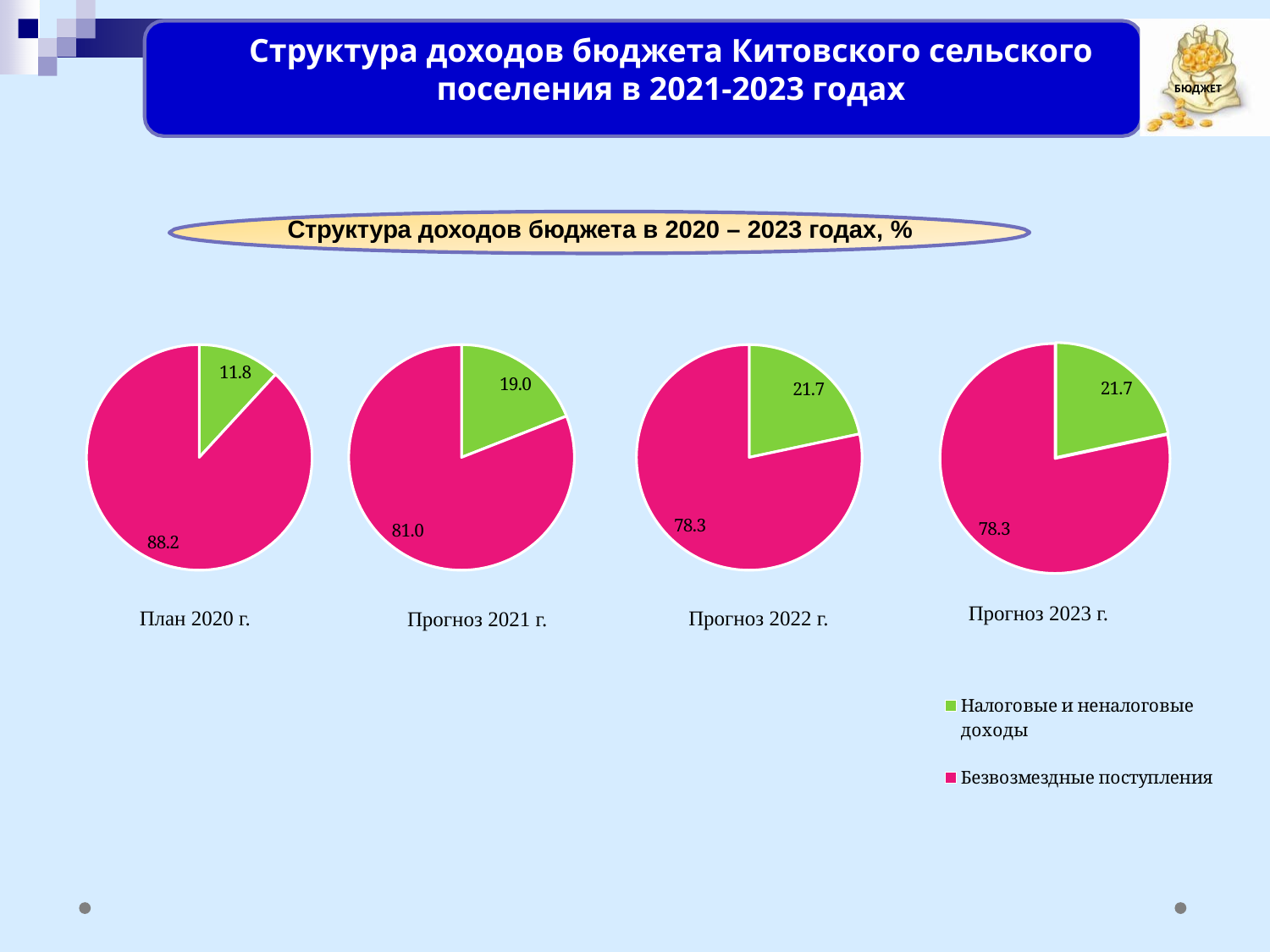
In the 'Прогноз 2022 г.' pie chart, what is the value for Безвозмездные поступления? 78.3 Which colour represents Безвозмездные поступления in the pie charts? Pink In the 'План 2020 г.' pie chart, what is the value for Налоговые и неналоговые доходы? 11.8 In the 'План 2020 г.' pie chart, what is the difference between the Безвозмездные поступления slice and the Налоговые и неналоговые доходы slice? 76.4 How many series does the legend list for the pie charts? 2 In the 'Прогноз 2021 г.' pie chart, which slice is larger: Налоговые и неналоговые доходы or Безвозмездные поступления? Безвозмездные поступления In the 'Прогноз 2021 г.' pie chart, what is the value for Налоговые и неналоговые доходы? 19.0 What kind of chart is used for 'Прогноз 2022 г.'? Pie chart In the 'План 2020 г.' pie chart, what is the value for Безвозмездные поступления? 88.2 Across the four pie charts from 'План 2020 г.' to 'Прогноз 2023 г.', does the share of Налоговые и неналоговые доходы rise or fall? Rise In the 'Прогноз 2023 г.' pie chart, what is the value for Налоговые и неналоговые доходы? 21.7 How many slices does the 'Прогноз 2023 г.' pie chart have? 2